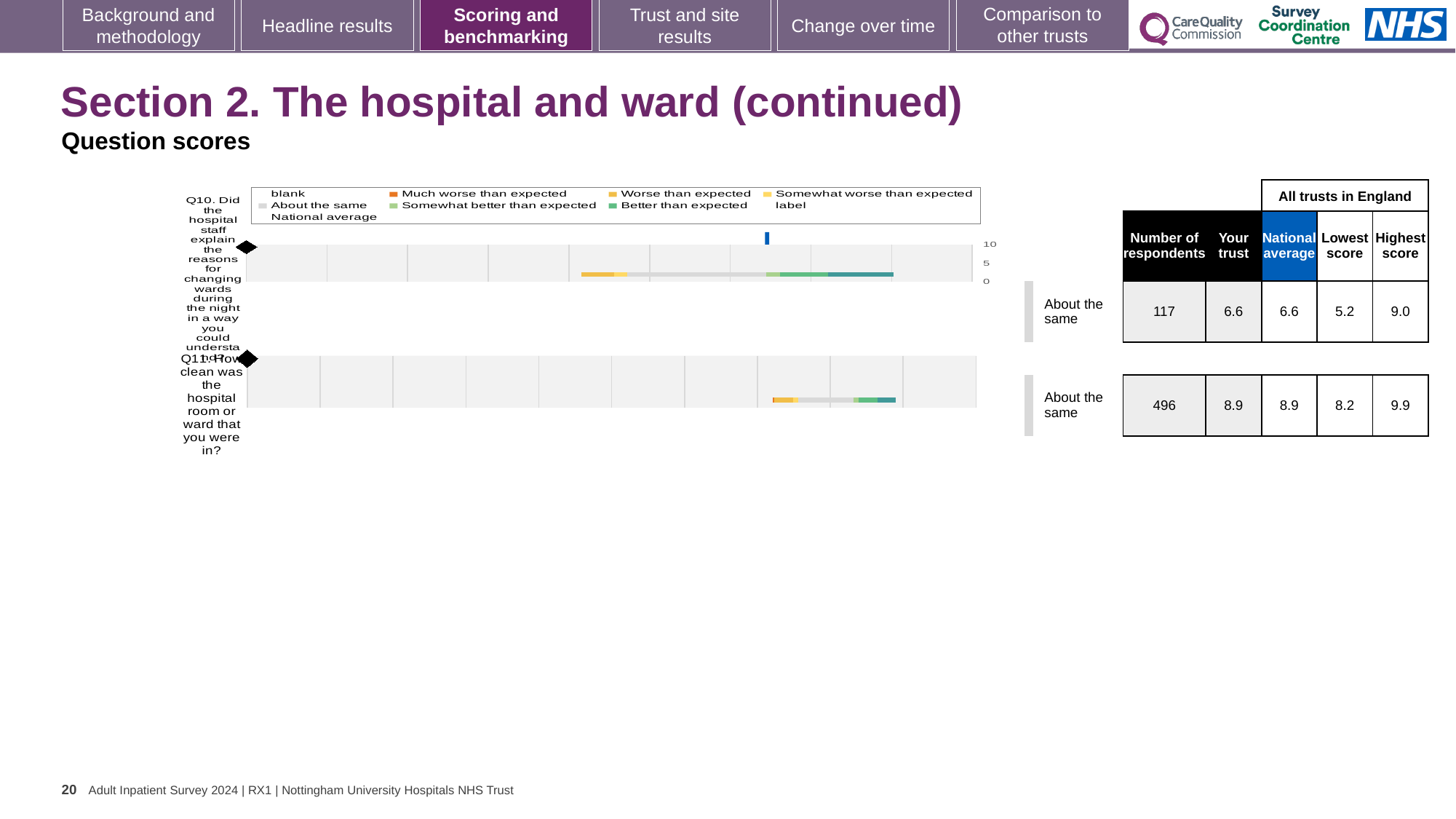
What is the 'Your trust' score for Q11 (how clean was the hospital room or ward)? 8.9 How many respondents answered Q11? 496 What is the national average score for Q11? 8.9 How many survey questions are charted on this slide? 2 What is the 'Your trust' score for Q10? 6.6 What is the difference between the highest and lowest trust scores for Q11? 1.7 What is the highest score among all trusts in England for Q11? 9.9 What is the lowest score among all trusts in England for Q10? 5.2 What benchmark category is shown for Q10's trust score? About the same How many respondents answered Q10 (explaining reasons for changing wards during the night)? 117 Which question had more respondents, Q10 or Q11? Q11 What is the difference between the highest and lowest trust scores for Q10? 3.8